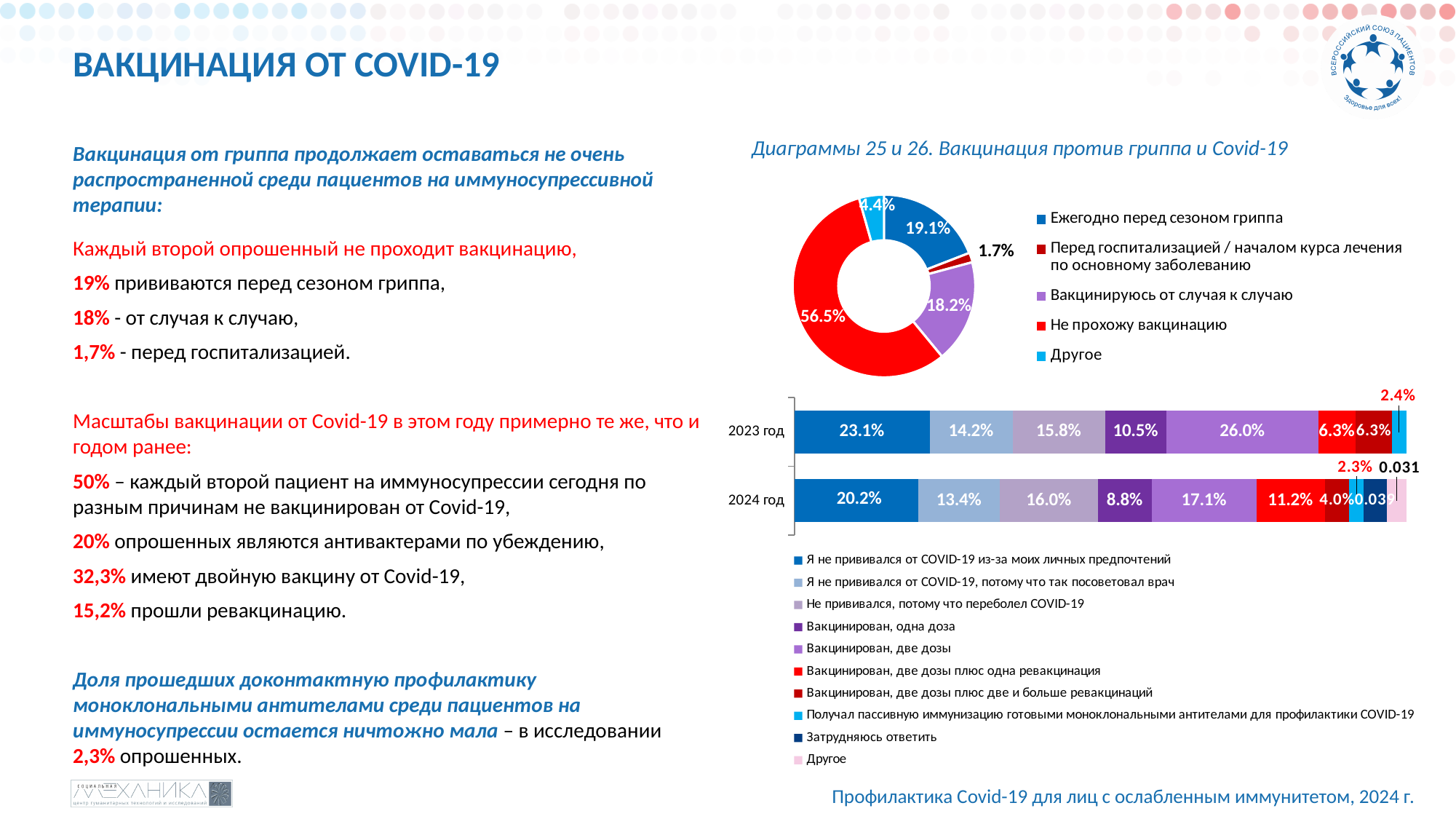
In the stacked bar chart on COVID-19 vaccination, what is the difference between the 2023 and 2024 values for 'Вакцинирован, две дозы'? 8.9% In the stacked bar chart on COVID-19 vaccination, what is the value for 'Я не прививался от COVID-19 из-за моих личных предпочтений' in 2023 год? 23.1% In the donut chart on the flu vaccination, what share of respondents answered 'Не прохожу вакцинацию'? 56.5% In the donut chart on the flu vaccination, which category has the largest share? Не прохожу вакцинацию In the stacked bar chart on COVID-19 vaccination, how many series does the legend list? 10 In the donut chart on the flu vaccination, what is the difference between 'Ежегодно перед сезоном гриппа' and 'Вакцинируюсь от случая к случаю'? 0.9% In the donut chart on the flu vaccination, how many categories does the legend list? 5 In the donut chart on the flu vaccination, which category has the smallest share? Перед госпитализацией / началом курса лечения по основному заболеванию What type of chart is the lower chart on COVID-19 vaccination by year? Stacked bar chart In the donut chart on the flu vaccination, what share of respondents answered 'Ежегодно перед сезоном гриппа'? 19.1% In the stacked bar chart on COVID-19 vaccination, which year has the larger value for 'Вакцинирован, две дозы плюс одна ревакцинация'? 2024 год In the stacked bar chart on COVID-19 vaccination, what is the value for 'Вакцинирован, две дозы' in 2024 год? 17.1%